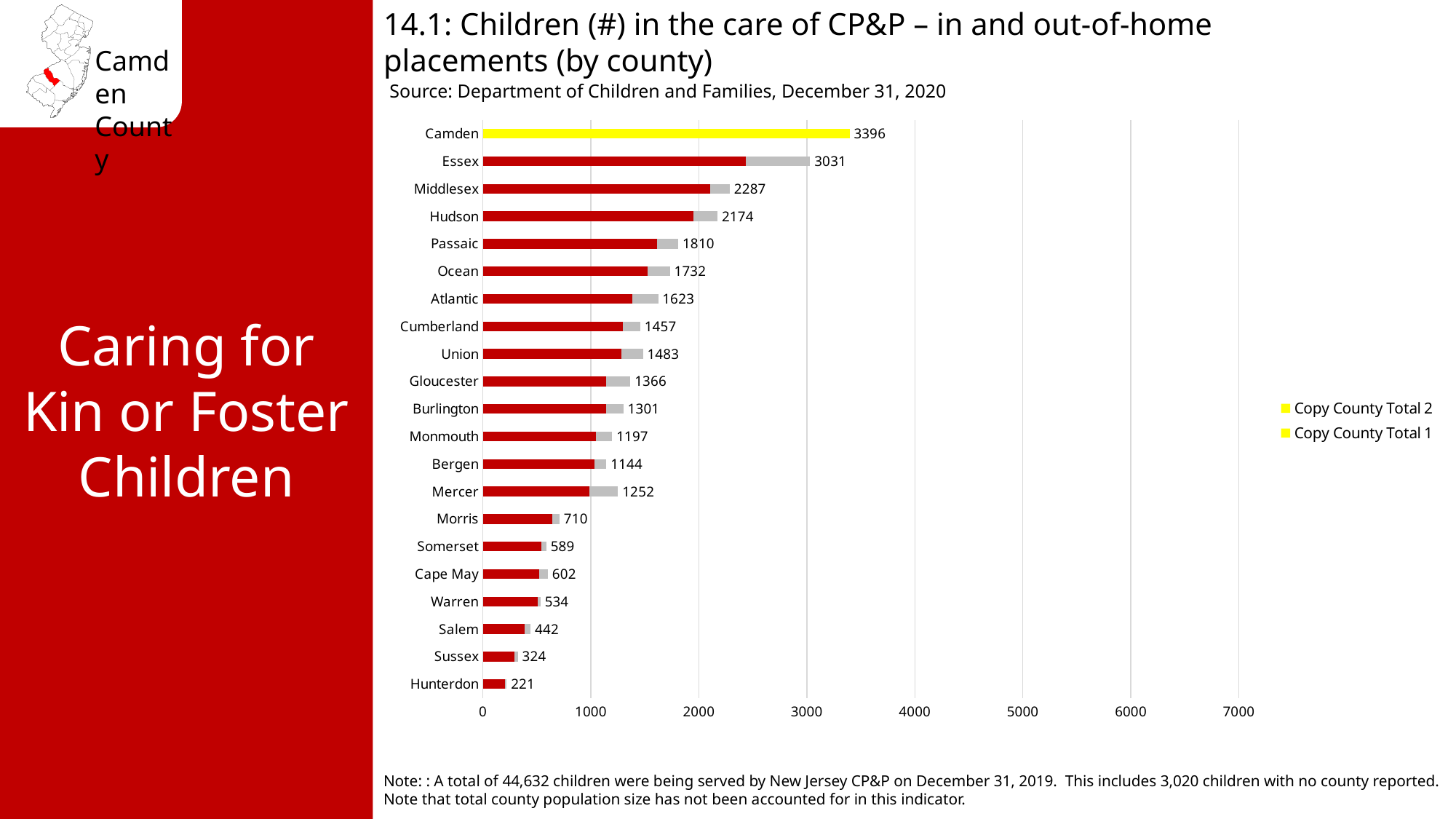
What is the total number of children in the care of CP&P for Camden County? 3396 What kind of chart is shown on the slide? bar chart What is the source cited for the chart data? Department of Children and Families, December 31, 2020 How many series does the legend list? 2 How many counties are shown on the chart? 21 Is the total value for Passaic greater or less than 2000? less Which county has the lowest total number of children in the care of CP&P? Hunterdon What is the total value shown for Hunterdon County? 221 What is the total value shown for Hudson County? 2174 What is the difference between the totals for Camden and Essex? 365 Which county has the highest total number of children in the care of CP&P? Camden Which county has a larger total, Union or Cumberland? Union